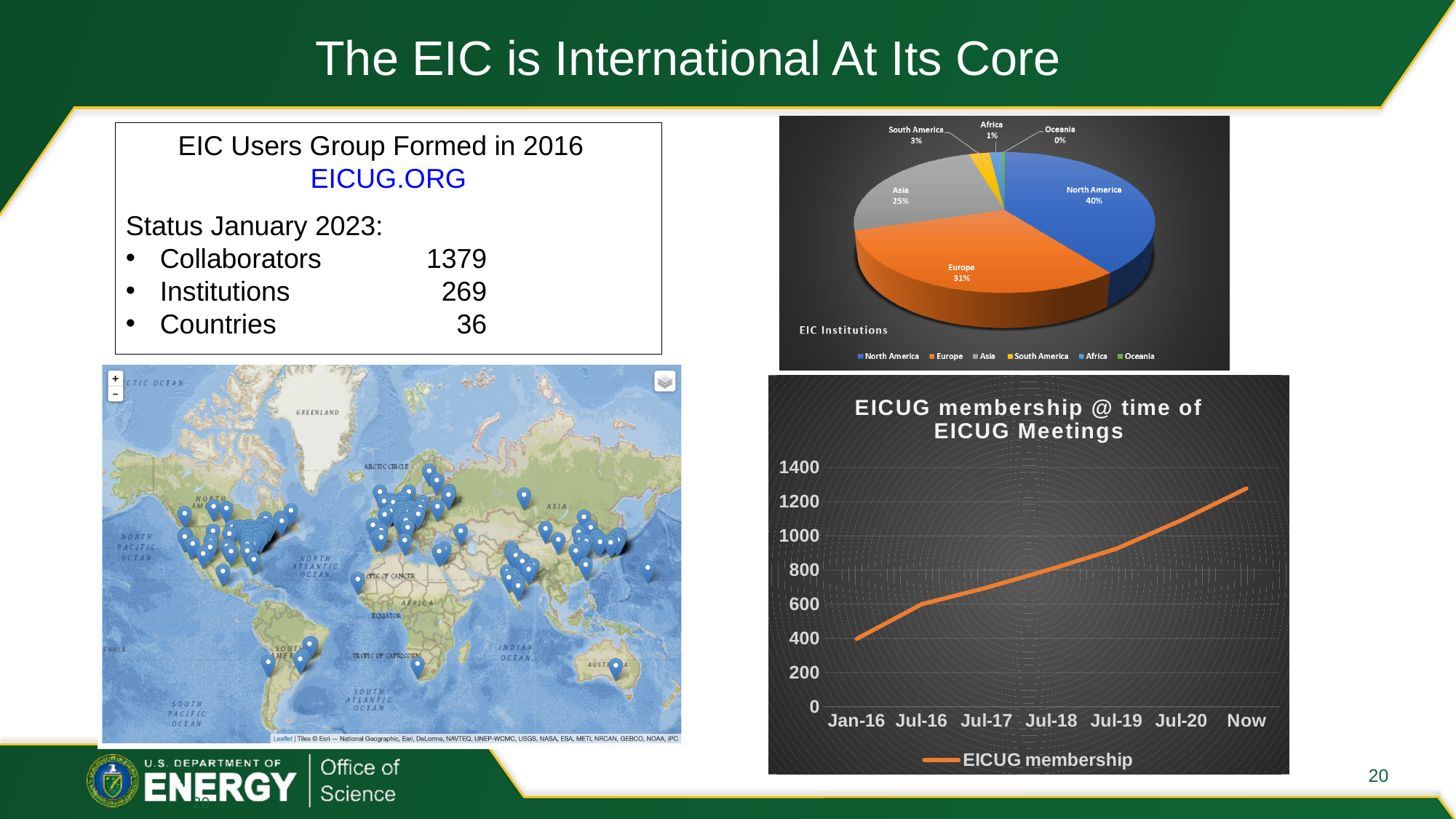
In the 'EICUG membership @ time of EICUG Meetings' chart, does membership rise or fall from Jan-16 to Now? rise In the 'EICUG membership @ time of EICUG Meetings' chart, is the value for Jan-16 greater or less than 600? less In the EIC Institutions pie chart, which has a larger share, South America or Africa? South America In the EIC Institutions pie chart, what share of institutions is from Europe? 31% What kind of chart is the 'EICUG membership @ time of EICUG Meetings' chart? line chart In the 'EICUG membership @ time of EICUG Meetings' chart, is the value for Now greater or less than 1200? greater How many regions does the legend of the EIC Institutions pie chart list? 6 In the EIC Institutions pie chart, what share of institutions is from North America? 40% In the EIC Institutions pie chart, which region has the smallest share? Oceania In the EIC Institutions pie chart, what share of institutions is from Asia? 25% In the EIC Institutions pie chart, what is the difference in percentage points between Europe and Asia? 6 In the EIC Institutions pie chart, which region has the largest share? North America